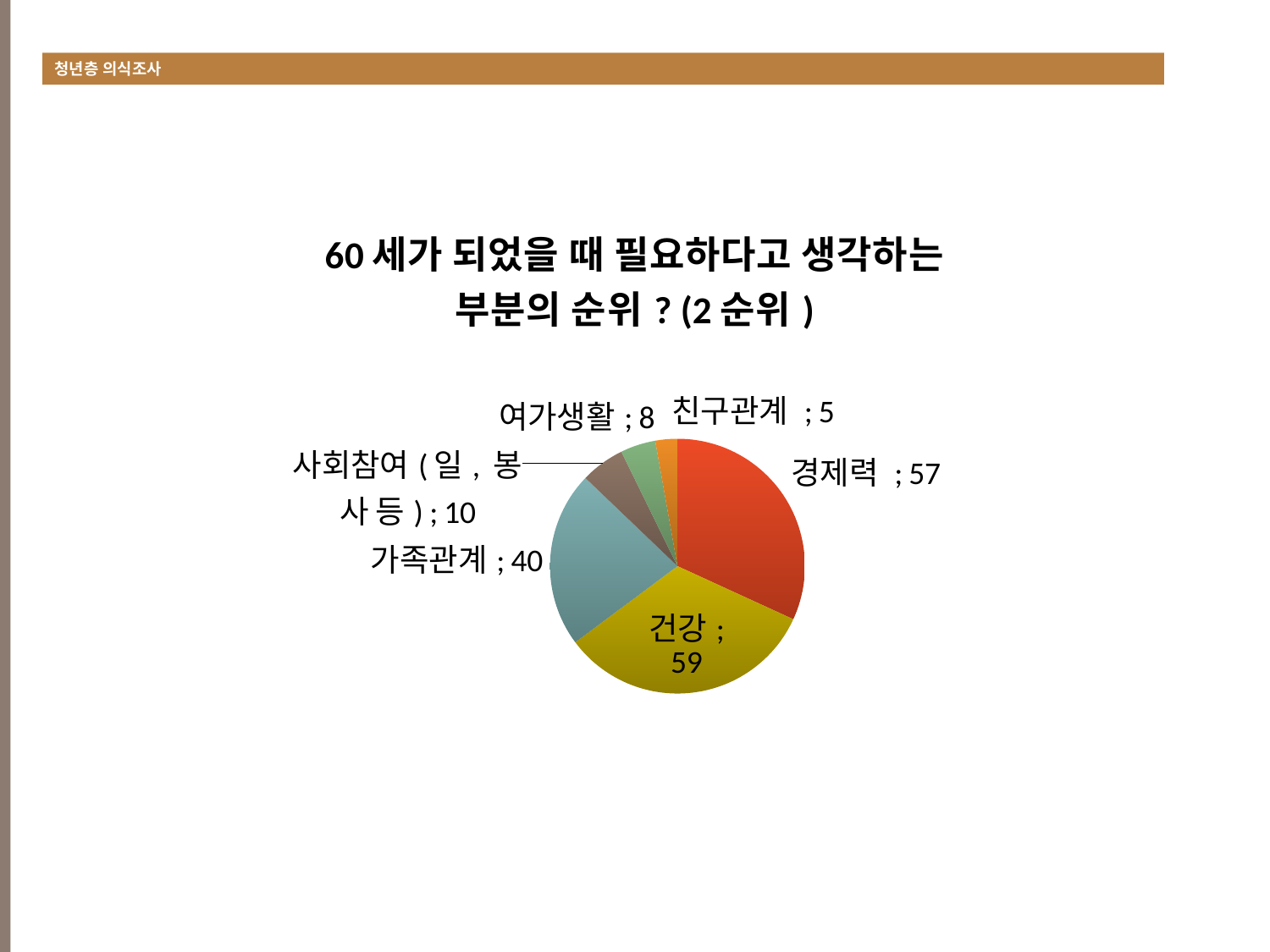
What value is shown for 가족관계 in the pie chart? 40 What is the difference between the values for 건강 and 경제력? 2 What value is shown for 경제력 in the pie chart? 57 Which is larger, the value for 여가생활 or the value for 친구관계? 여가생활 Which category has the largest slice in the pie chart? 건강 What is the total of all the values shown in the pie chart? 179 What kind of chart is shown on the slide? Pie chart What value is shown for 건강 in the pie chart? 59 How many categories are shown in the pie chart? 6 Which category has the smallest slice in the pie chart? 친구관계 What value is shown for 사회참여 (일, 봉사 등) in the pie chart? 10 What is the difference between the values for 가족관계 and 사회참여 (일, 봉사 등)? 30